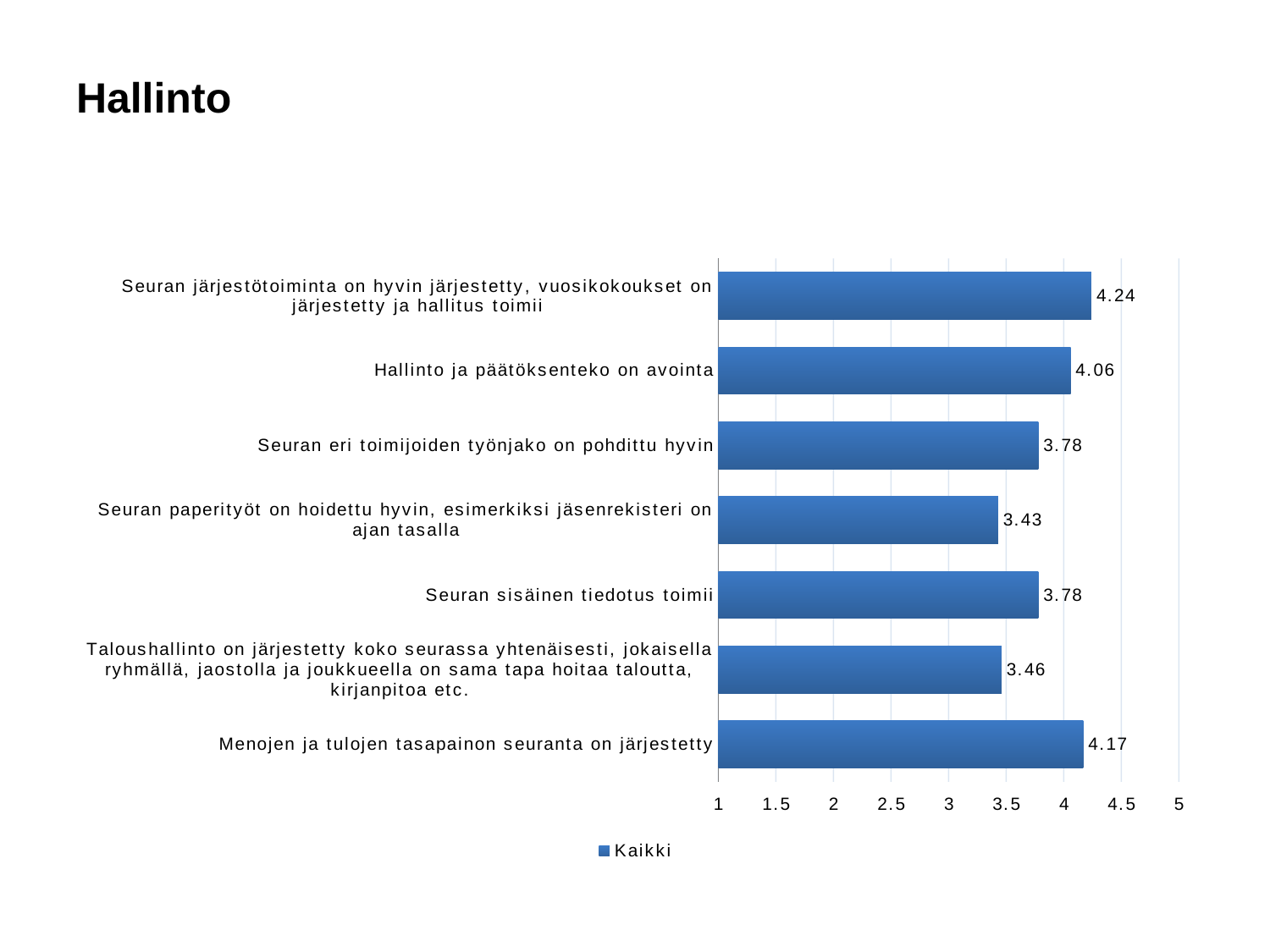
Which is larger: the value for "Seuran sisäinen tiedotus toimii" or the value for "Taloushallinto on järjestetty koko seurassa yhtenäisesti, jokaisella ryhmällä, jaostolla ja joukkueella on sama tapa hoitaa taloutta, kirjanpitoa etc."? Seuran sisäinen tiedotus toimii What kind of chart is shown on the slide? bar chart What is the name of the series shown in the legend? Kaikki Which category has the highest value? Seuran järjestötoiminta on hyvin järjestetty, vuosikokoukset on järjestetty ja hallitus toimii How many series does the legend list? 1 What is the value for "Seuran paperityöt on hoidettu hyvin, esimerkiksi jäsenrekisteri on ajan tasalla"? 3.43 What is the value for "Menojen ja tulojen tasapainon seuranta on järjestetty"? 4.17 How many categories are shown in the chart? 7 What is the value for "Hallinto ja päätöksenteko on avointa"? 4.06 Which category has the lowest value? Seuran paperityöt on hoidettu hyvin, esimerkiksi jäsenrekisteri on ajan tasalla What is the difference between the values for "Seuran järjestötoiminta on hyvin järjestetty, vuosikokoukset on järjestetty ja hallitus toimii" and "Hallinto ja päätöksenteko on avointa"? 0.18 Is the value for "Seuran eri toimijoiden työnjako on pohdittu hyvin" greater or less than 3.5? greater